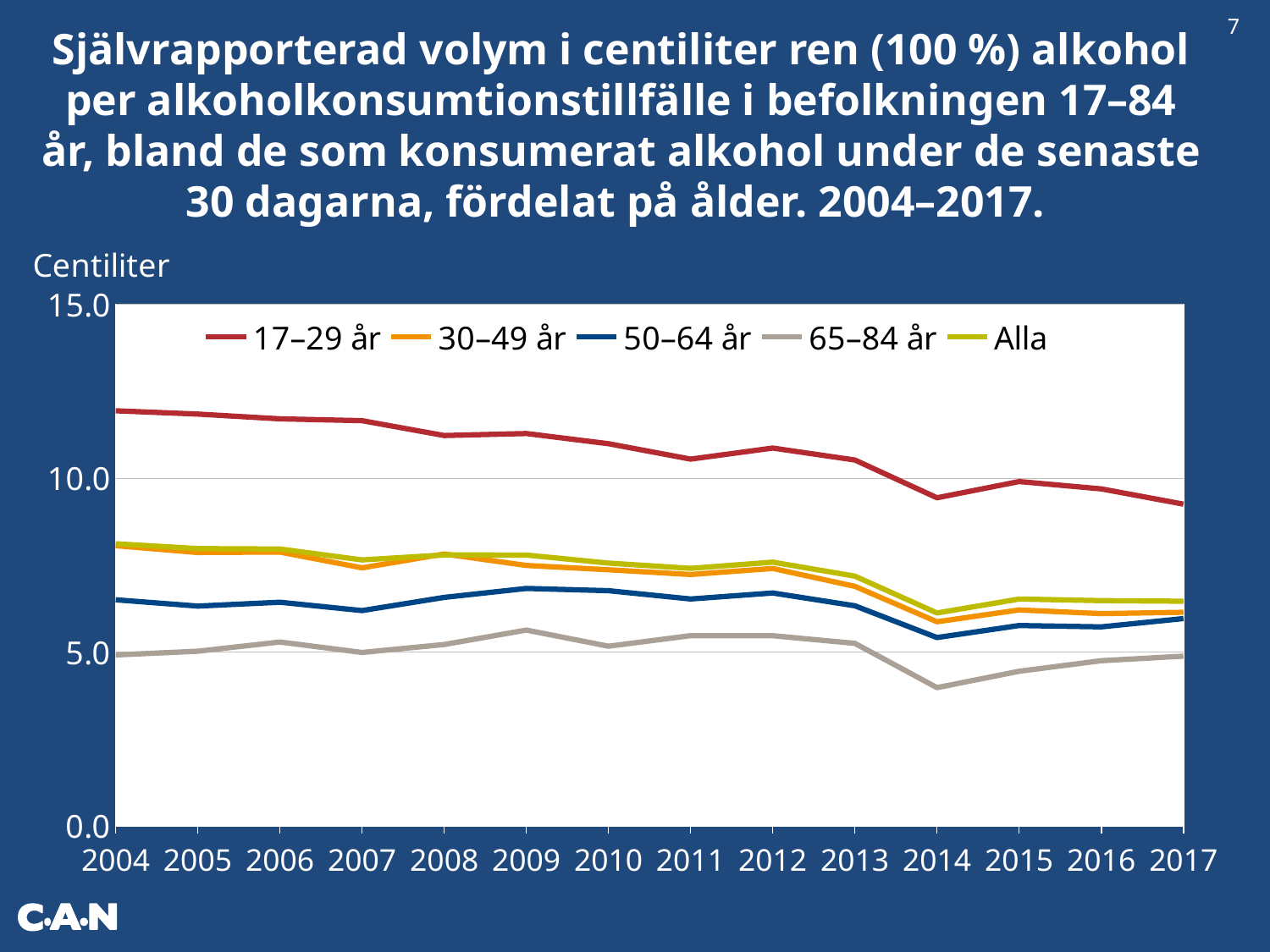
What unit label is shown above the y axis? Centiliter Is the value for 17–29 år in 2004 greater or less than 10.0? greater Does the line for 17–29 år rise or fall from 2004 to 2017? fall What kind of chart is shown on the slide? line chart Is the value for 65–84 år in 2014 greater or less than 5.0? less Is the value for 17–29 år in 2017 greater or less than 10.0? less How many series does the legend list? 5 How many years are plotted along the x axis? 14 In 2010, which is larger: the value for 17–29 år or the value for 65–84 år? 17–29 år Which age group has the highest value in 2017? 17–29 år Which age group has the lowest value in 2004? 65–84 år